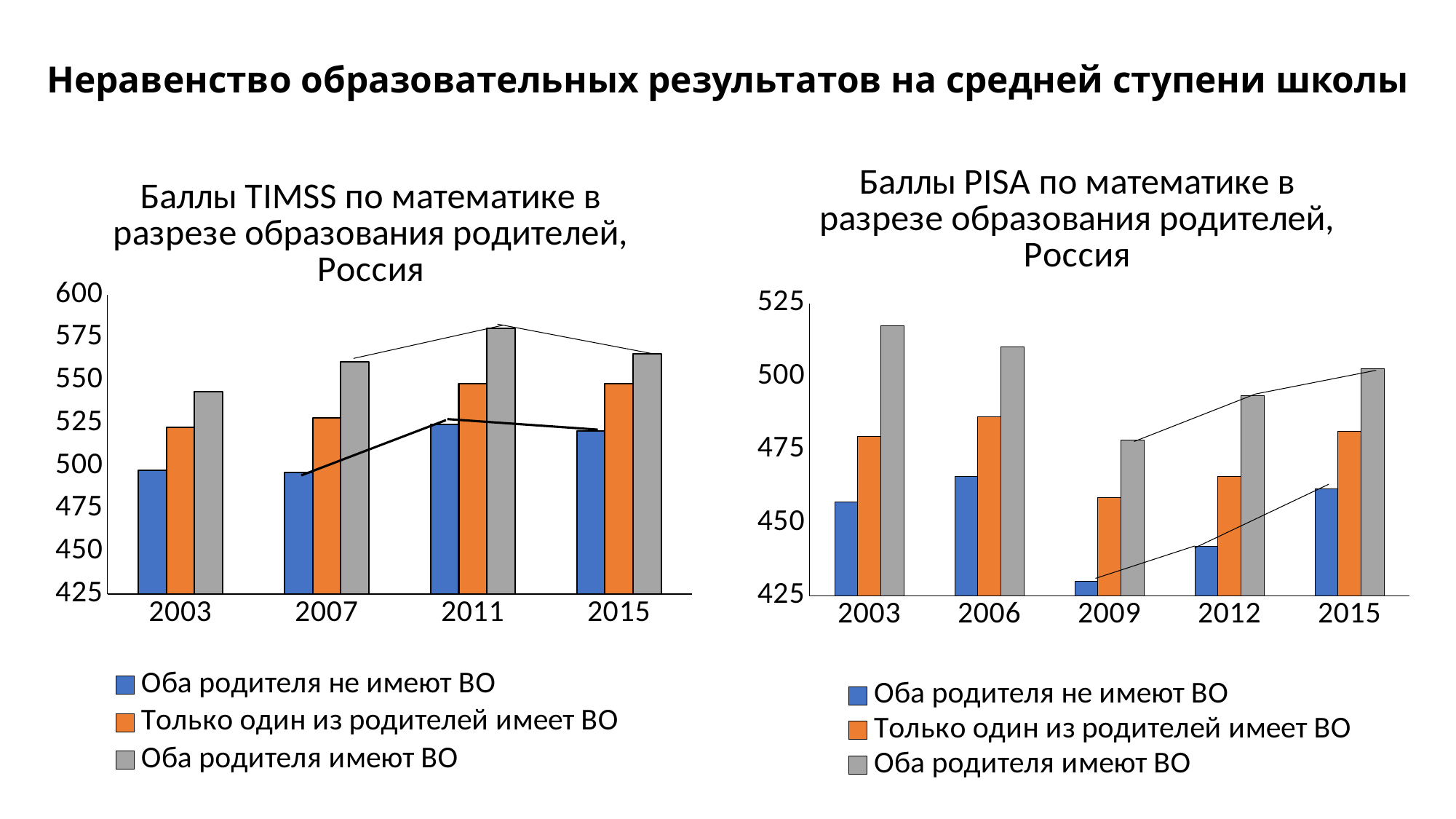
In the right chart (PISA), is the value for 'Оба родителя имеют ВО' larger in 2003 or in 2015? 2003 In the left chart (TIMSS), how many years are shown on the x axis? 4 In the right chart (PISA), in which year is the value for 'Оба родителя не имеют ВО' the lowest? 2009 In the right chart (PISA), how many series does the legend list? 3 In the right chart (PISA), how many years are shown on the x axis? 5 In the left chart (TIMSS), in which year is the value for 'Оба родителя имеют ВО' the highest? 2011 In the right chart (PISA), in which year is the value for 'Оба родителя имеют ВО' the highest? 2003 In the left chart (TIMSS), is the value for 'Только один из родителей имеет ВО' in 2007 greater or less than 500? greater In the right chart (PISA), is the value for 'Оба родителя не имеют ВО' in 2009 greater or less than 450? less What kind of chart is the left chart, 'Баллы TIMSS по математике в разрезе образования родителей, Россия'? bar chart In the left chart (TIMSS), is the value for 'Оба родителя имеют ВО' in 2011 greater or less than 550? greater In the right chart (PISA), do the values for 'Оба родителя имеют ВО' rise or fall from 2009 to 2015? rise